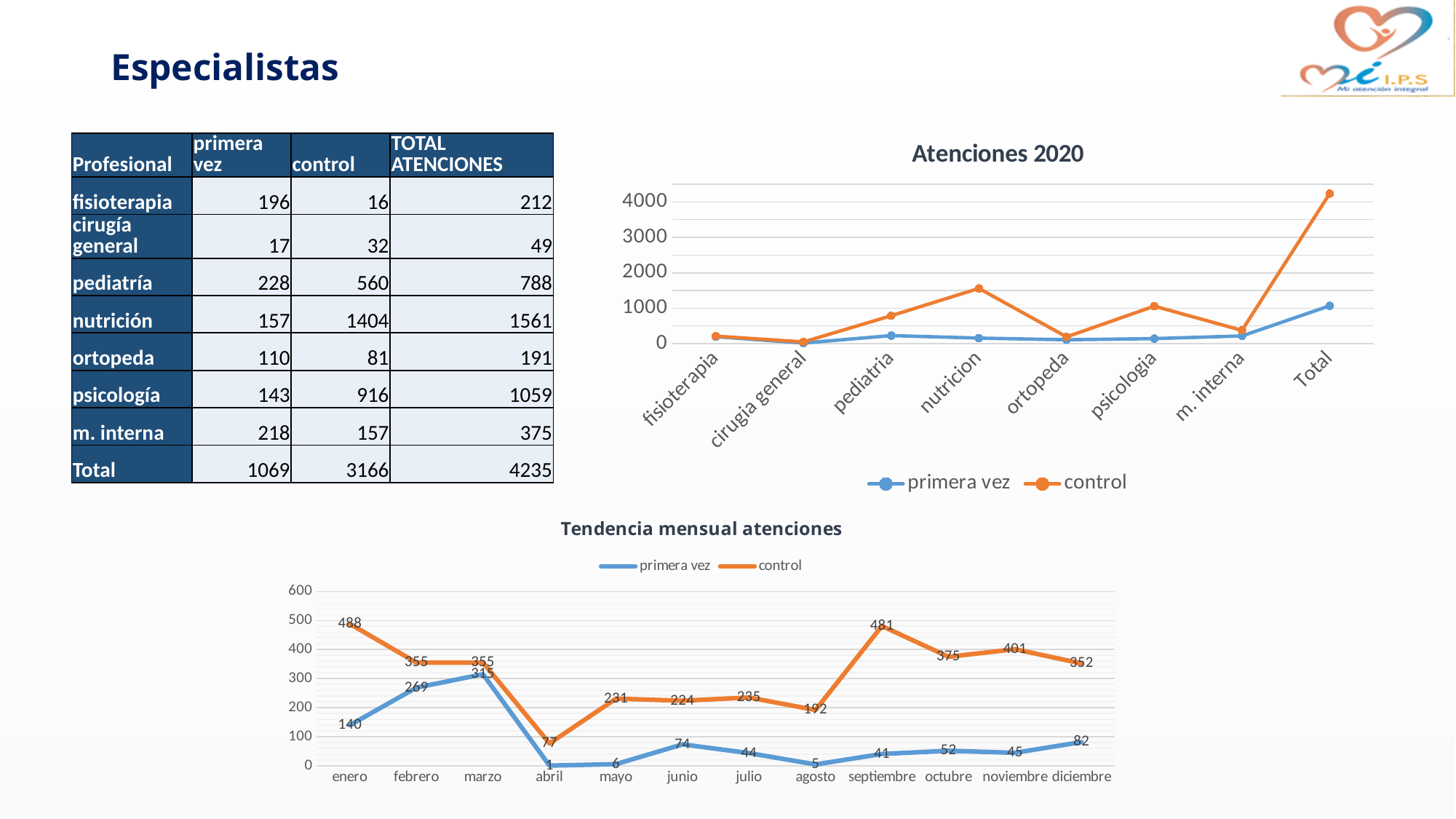
How many months are shown on the x axis of the 'Tendencia mensual atenciones' chart? 12 In the 'Tendencia mensual atenciones' chart, which month has the lowest primera vez value? abril In the 'Atenciones 2020' chart, which category has the highest control value? Total In the 'Tendencia mensual atenciones' chart, what is the value for control in septiembre? 481 In the 'Tendencia mensual atenciones' chart, what is the value for primera vez in marzo? 315 In the 'Tendencia mensual atenciones' chart, which month has the highest control value? enero In the 'Tendencia mensual atenciones' chart, what is the difference between control and primera vez in diciembre? 270 In the 'Tendencia mensual atenciones' chart, what is the value for control in enero? 488 In the 'Atenciones 2020' chart, is the control value for nutricion greater or less than 1000? greater What kind of chart is 'Atenciones 2020'? line chart How many series does the legend of the 'Atenciones 2020' chart list? 2 In the 'Tendencia mensual atenciones' chart, which is larger: primera vez in febrero or primera vez in junio? febrero